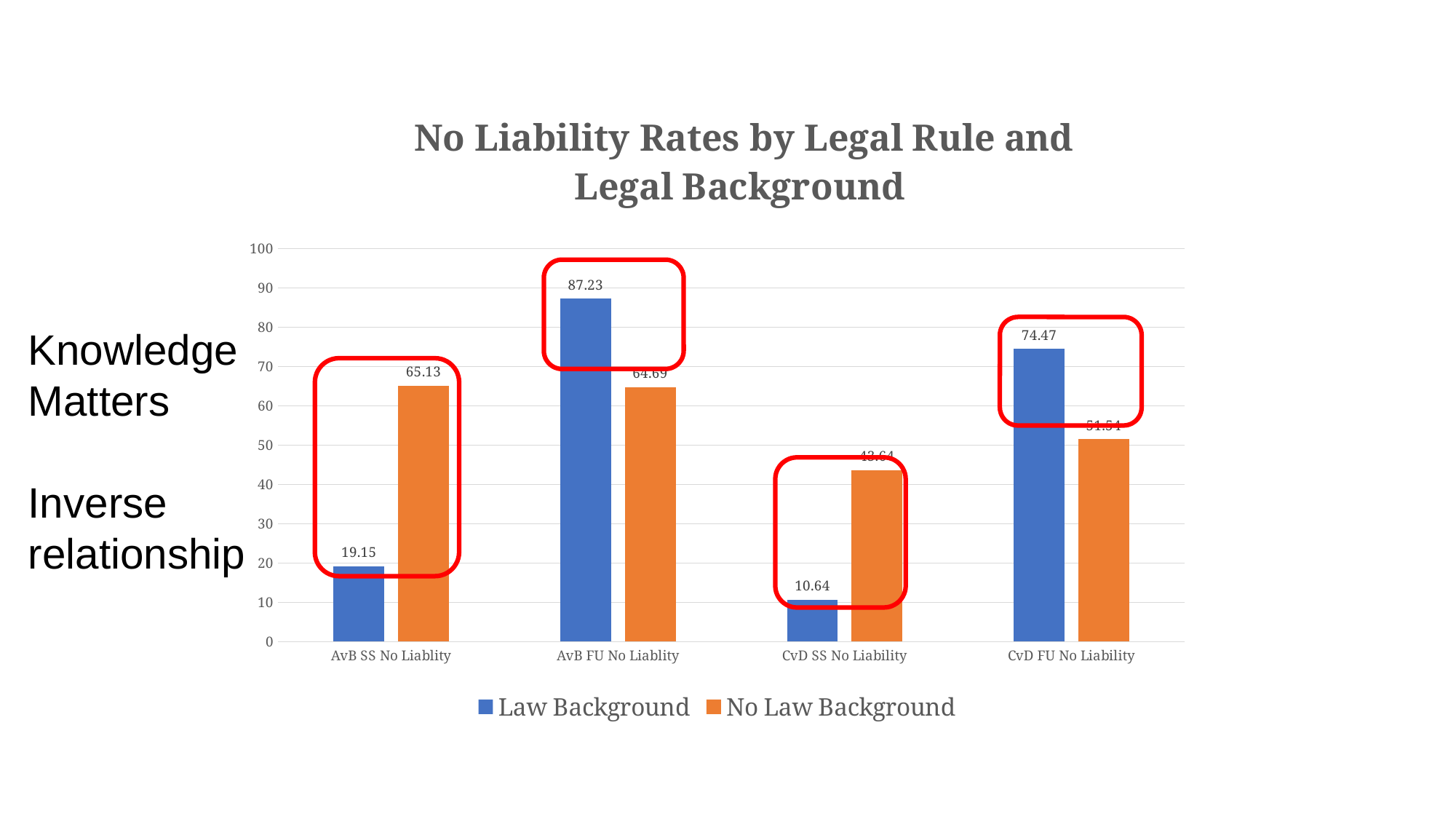
How many series does the legend list? 2 Which category has the lowest Law Background value? CvD SS No Liability How many categories are shown on the x axis? 4 What type of chart is shown on the slide? bar chart What is the value for Law Background in the CvD FU No Liability category? 74.47 Is the No Law Background value for CvD SS No Liability greater or less than 50? less In the AvB FU No Liablity category, which series has the larger value, Law Background or No Law Background? Law Background What is the value for Law Background in the CvD SS No Liability category? 10.64 What is the value for No Law Background in the AvB SS No Liablity category? 65.13 What is the difference between the No Law Background and Law Background values in the AvB SS No Liablity category? 45.98 Which category has the highest Law Background value? AvB FU No Liablity What is the No Liability rate for Law Background in the AvB FU No Liablity category? 87.23